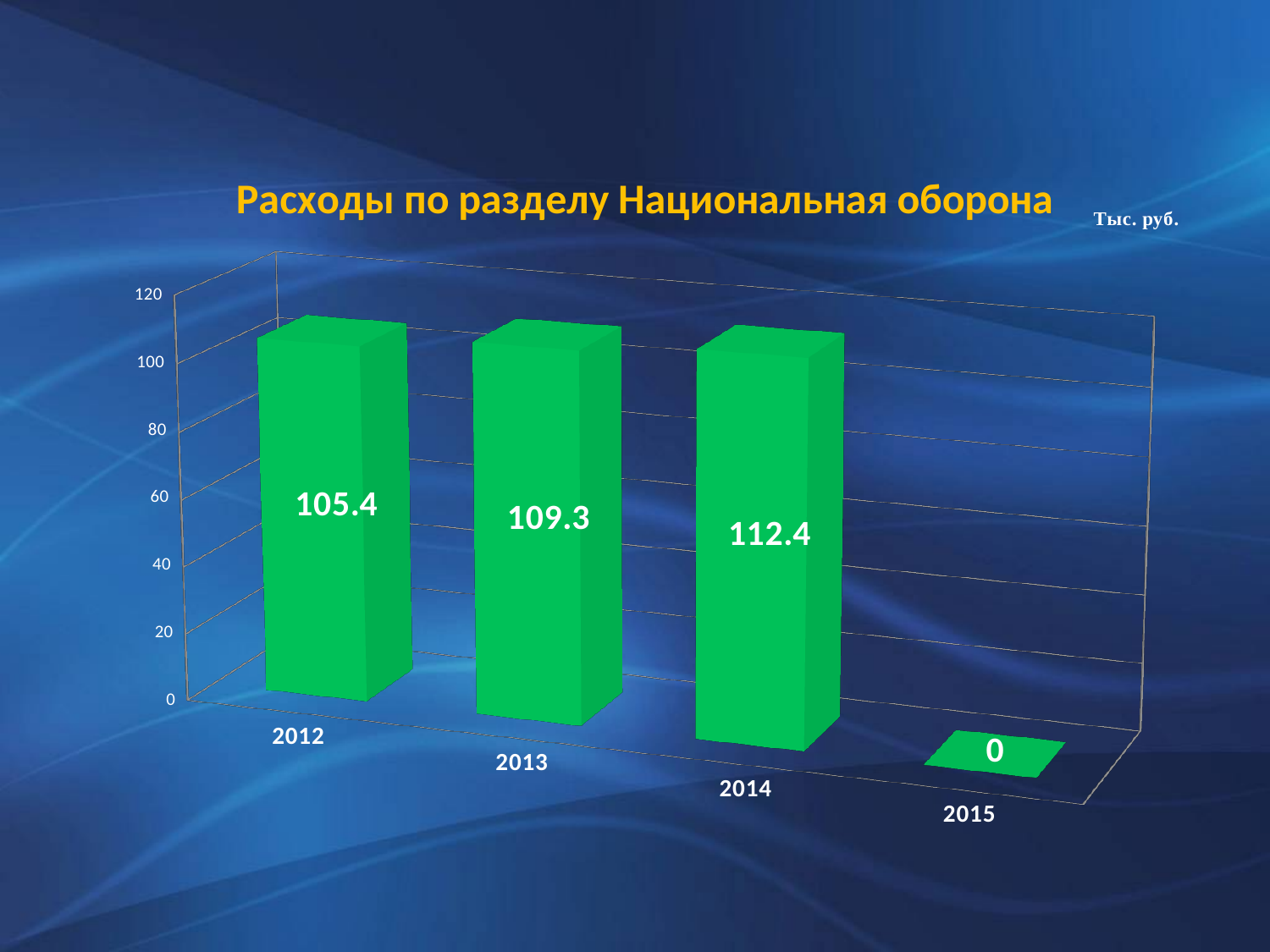
What is the value for 2014? 112.4 What is the difference between the values for 2013 and 2012? 3.9 Which is larger, the value for 2013 or the value for 2014? 2014 What is the title of the chart? Расходы по разделу Национальная оборона Which year has the lowest value? 2015 Which year has the highest value? 2014 How many years are shown on the chart? 4 What is the value for 2013? 109.3 What is the value for 2012? 105.4 What kind of chart is shown on the slide? bar chart What is the value for 2015? 0 What is the difference between the values for 2014 and 2012? 7